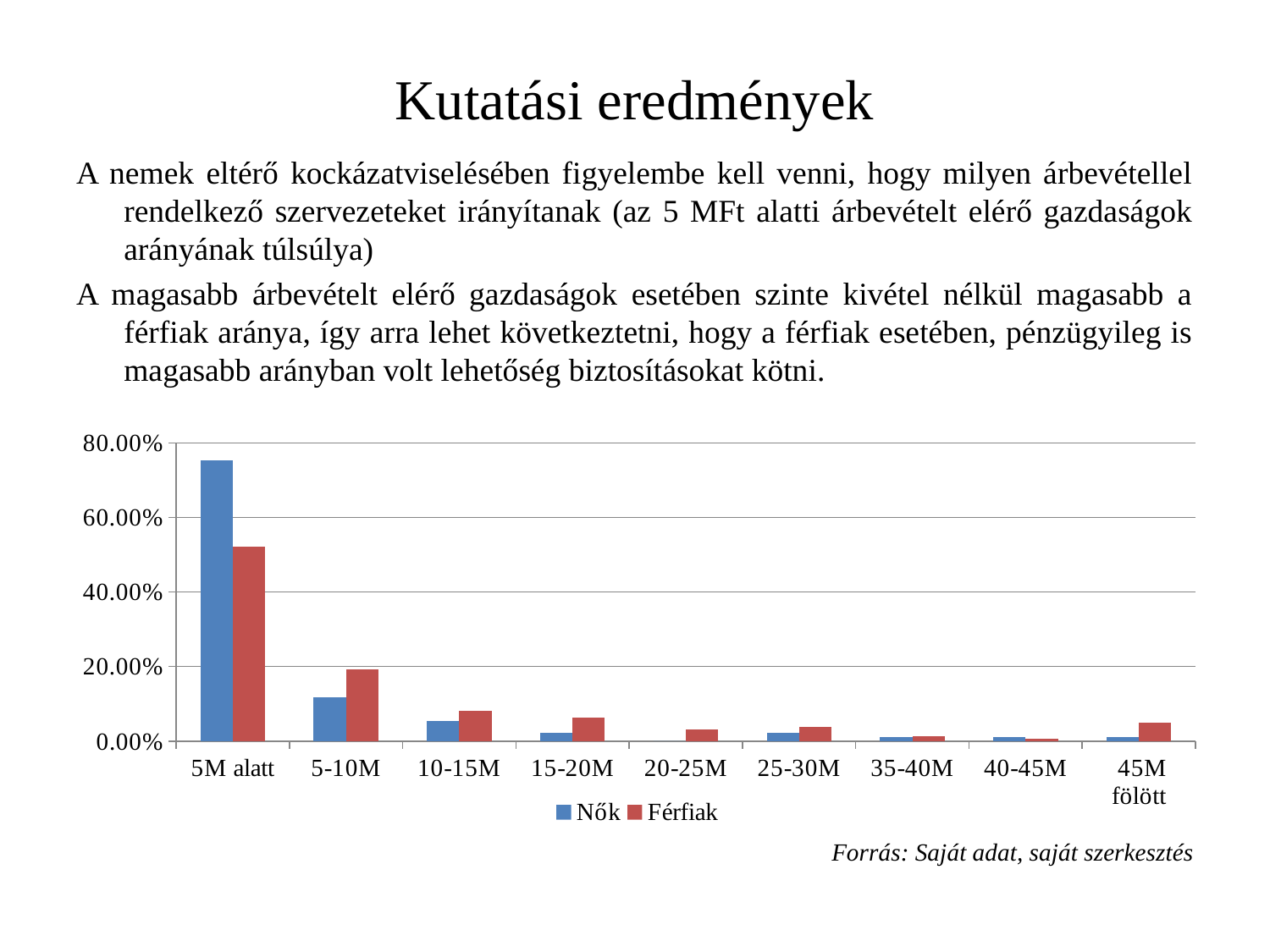
In the 5-10M category, which series has the larger value, Nők or Férfiak? Férfiak What are the two entries in the chart legend? Nők and Férfiak How many series does the legend list? 2 Do the values for Nők generally rise or fall moving from 5M alatt to 45M fölött along the x axis? fall In the 5M alatt category, which series has the larger value, Nők or Férfiak? Nők Which category has the highest value for Nők? 5M alatt What kind of chart is shown on the slide? bar chart How many revenue categories are shown on the x axis? 9 Which category has the highest value for Férfiak? 5M alatt Is the value for Nők in the 5M alatt category greater or less than 60.00%? greater Is the value for Férfiak in the 5M alatt category greater or less than 60.00%? less